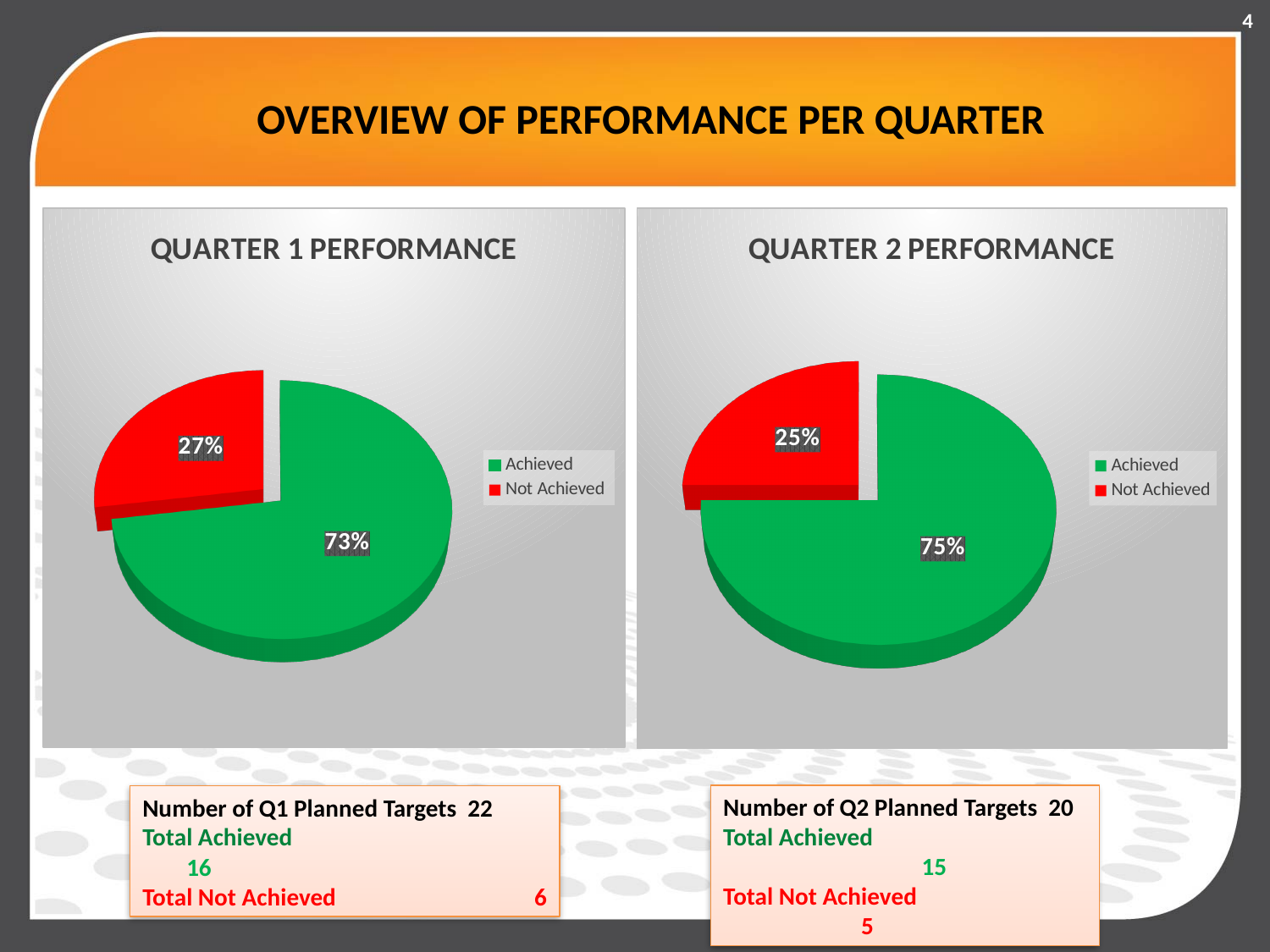
How many slices does the Quarter 1 Performance pie chart have? 2 In the Quarter 2 Performance chart, which slice is the smallest? Not Achieved In the Quarter 1 Performance chart, what percentage is shown for Achieved? 73% In the Quarter 2 Performance chart, what percentage is shown for Not Achieved? 25% In the Quarter 1 Performance chart, what colour is the Not Achieved slice? Red How many entries does the legend of the Quarter 2 Performance chart list? 2 In the Quarter 2 Performance chart, what percentage is shown for Achieved? 75% In the Quarter 1 Performance chart, what is the difference in percentage points between Achieved and Not Achieved? 46 What type of chart is the Quarter 2 Performance chart? Pie chart Which is larger: the Achieved share in the Quarter 1 Performance chart or the Achieved share in the Quarter 2 Performance chart? Quarter 2 Performance In the Quarter 1 Performance chart, which slice is the largest? Achieved In the Quarter 1 Performance chart, what percentage is shown for Not Achieved? 27%